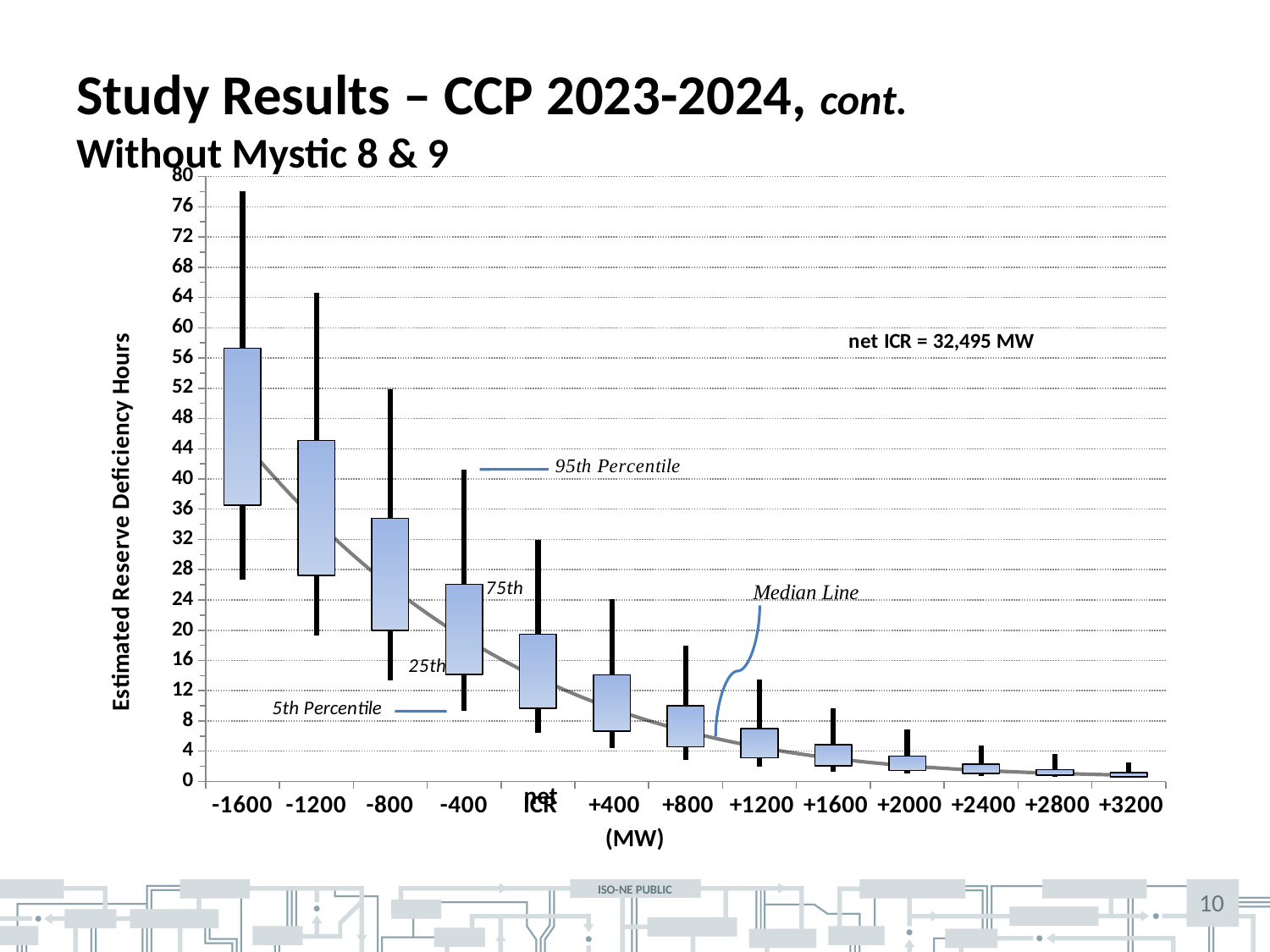
Is the 95th percentile value for -400 greater or less than 36? greater Do the estimated reserve deficiency hours rise or fall as the x-axis values increase from -1600 to +3200? fall Which x-axis category has the highest 95th percentile of estimated reserve deficiency hours? -1600 Which has the larger median estimated reserve deficiency hours, -1200 or +400? -1200 Is the 5th percentile value for -1600 greater or less than 24? greater What net ICR value is annotated on the chart? net ICR = 32,495 MW Is the 95th percentile value for -1600 greater or less than 72? greater Which x-axis category has the lowest median estimated reserve deficiency hours? +3200 How many categories are shown along the x axis of the chart? 13 What kind of chart is shown on the slide? box-and-whisker (box plot) chart